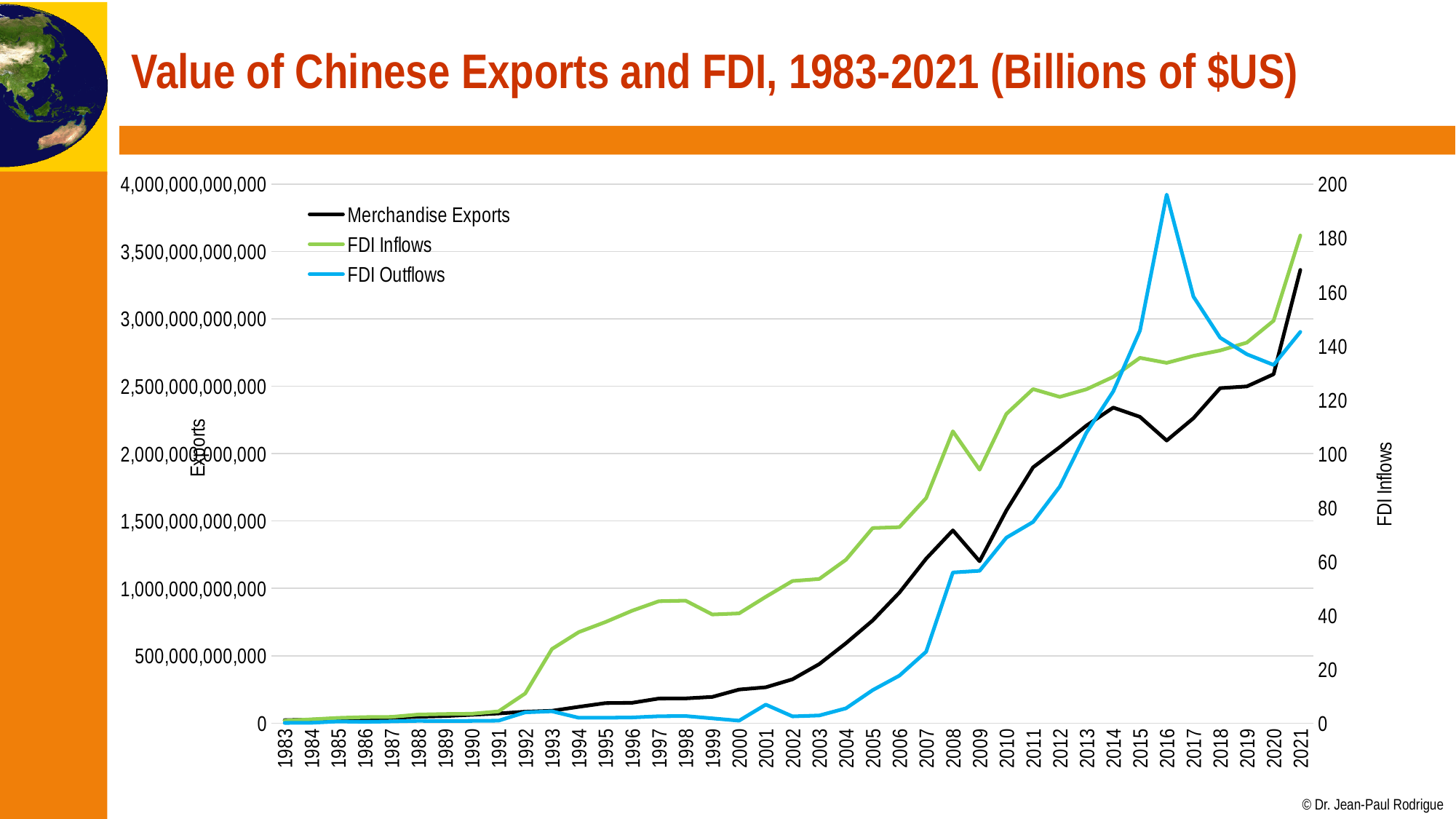
Is the value for FDI Inflows in 2021 greater or less than 160? greater In which year does the FDI Outflows line reach its highest value? 2016 How many series does the legend list? 3 Does the Merchandise Exports line rise or fall from 2008 to 2009? Fall What is the label of the right-hand vertical axis? FDI Inflows What kind of chart is shown on the slide? Line chart Is the value for FDI Outflows in 2016 greater or less than 180? greater How many years are plotted along the x axis? 39 Is the value for Merchandise Exports in 2021 greater or less than 3,000,000,000,000? greater In 2016, which is larger: FDI Inflows or FDI Outflows? FDI Outflows In which year does the Merchandise Exports line reach its highest value? 2021